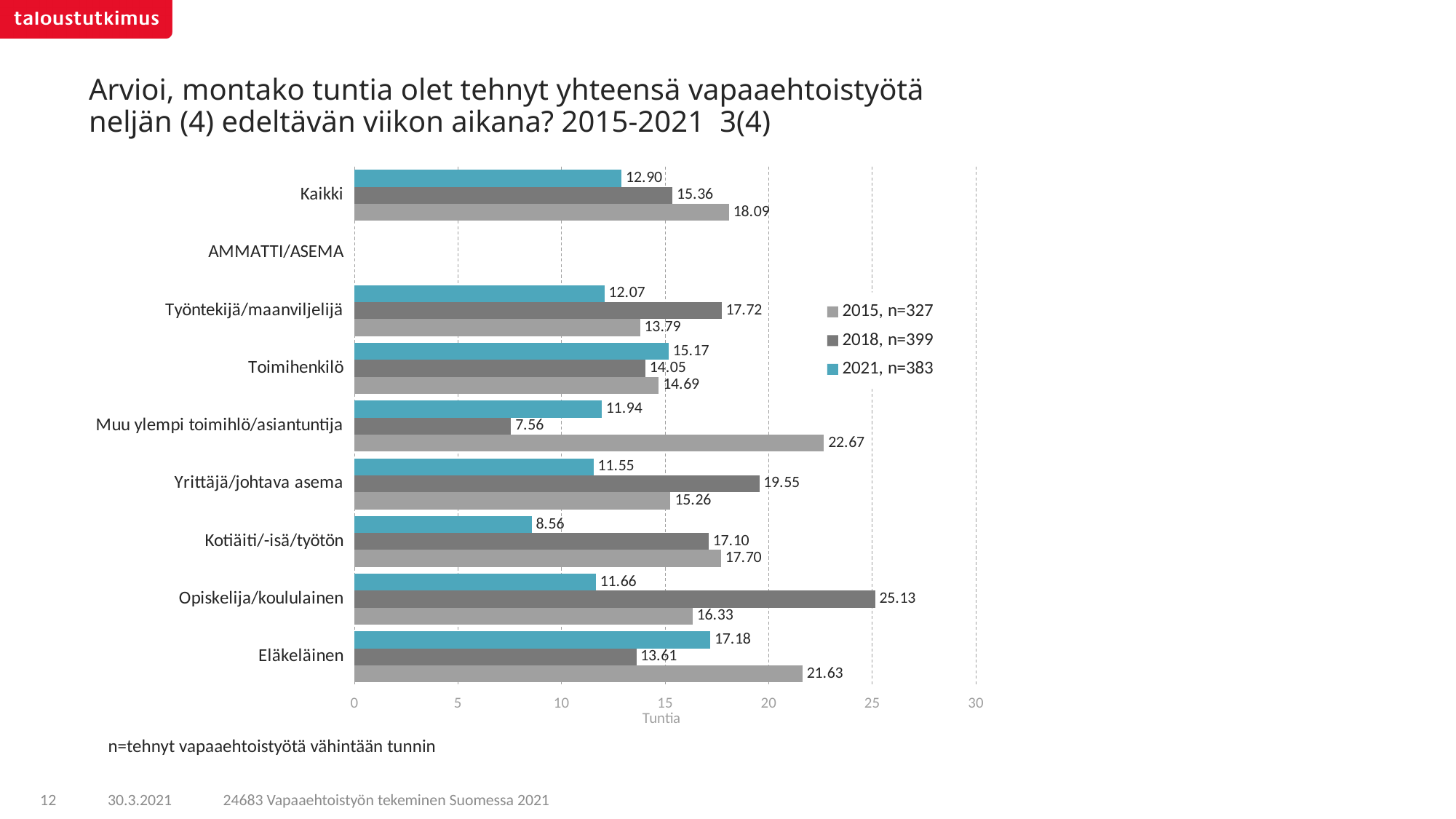
What is the 2015 value for Muu ylempi toimihlö/asiantuntija? 22.67 Which is larger for Yrittäjä/johtava asema: the 2018 value or the 2015 value? 2018 How many series does the legend list? 3 What is the sample size (n) for the 2018 series in the legend? 399 Is the 2018 value for Muu ylempi toimihlö/asiantuntija greater or less than 10? less Which category has the lowest 2021 value? Kotiäiti/-isä/työtön What is the 2018 value for Opiskelija/koululainen? 25.13 What is the label of the x axis? Tuntia Which category has the highest 2018 value? Opiskelija/koululainen What kind of chart is shown? bar chart What is the difference between the 2015 and 2021 values for Eläkeläinen? 4.45 What is the 2021 value for Kaikki? 12.90